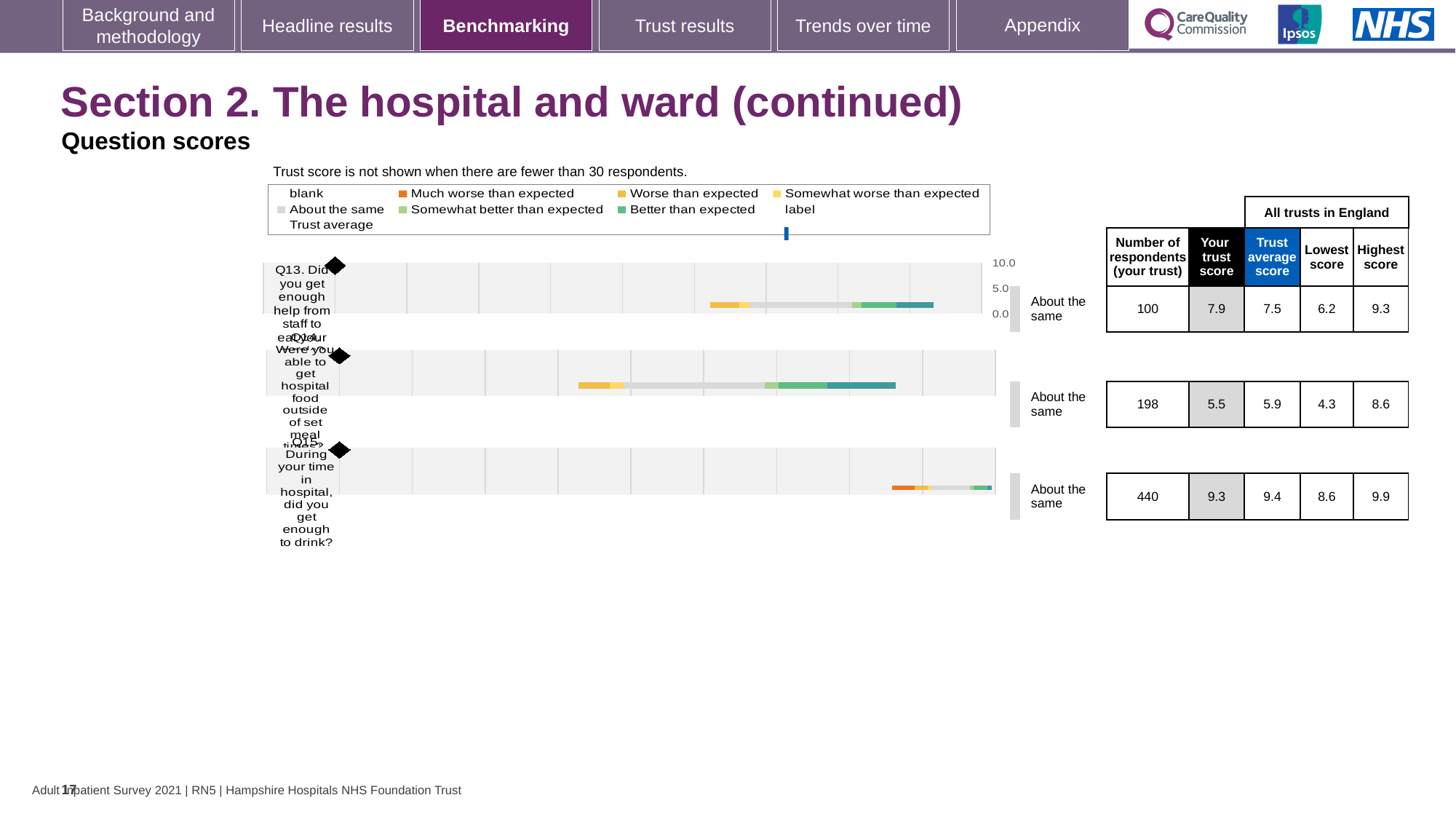
What is the number of respondents for Q15 (did you get enough to drink)? 440 For Q13, what is the difference between 'Your trust score' and the 'Trust average score'? 0.4 Which question has the lowest 'Your trust score'? Q14 What kind of chart is used to show the question scores on this slide? bar chart How many questions are plotted in the chart? 3 What benchmark category is shown next to the bar for Q14? About the same For Q14, which is larger: 'Your trust score' or the 'Trust average score'? Trust average score For Q15, what is the difference between the highest score and the lowest score across all trusts in England? 1.3 Which question has the highest 'Your trust score'? Q15 What is the 'Lowest score' across all trusts in England for Q13? 6.2 What is the 'Highest score' across all trusts in England for Q14? 8.6 What is the 'Your trust score' for Q13 (Did you get enough help from staff to eat your meals)? 7.9